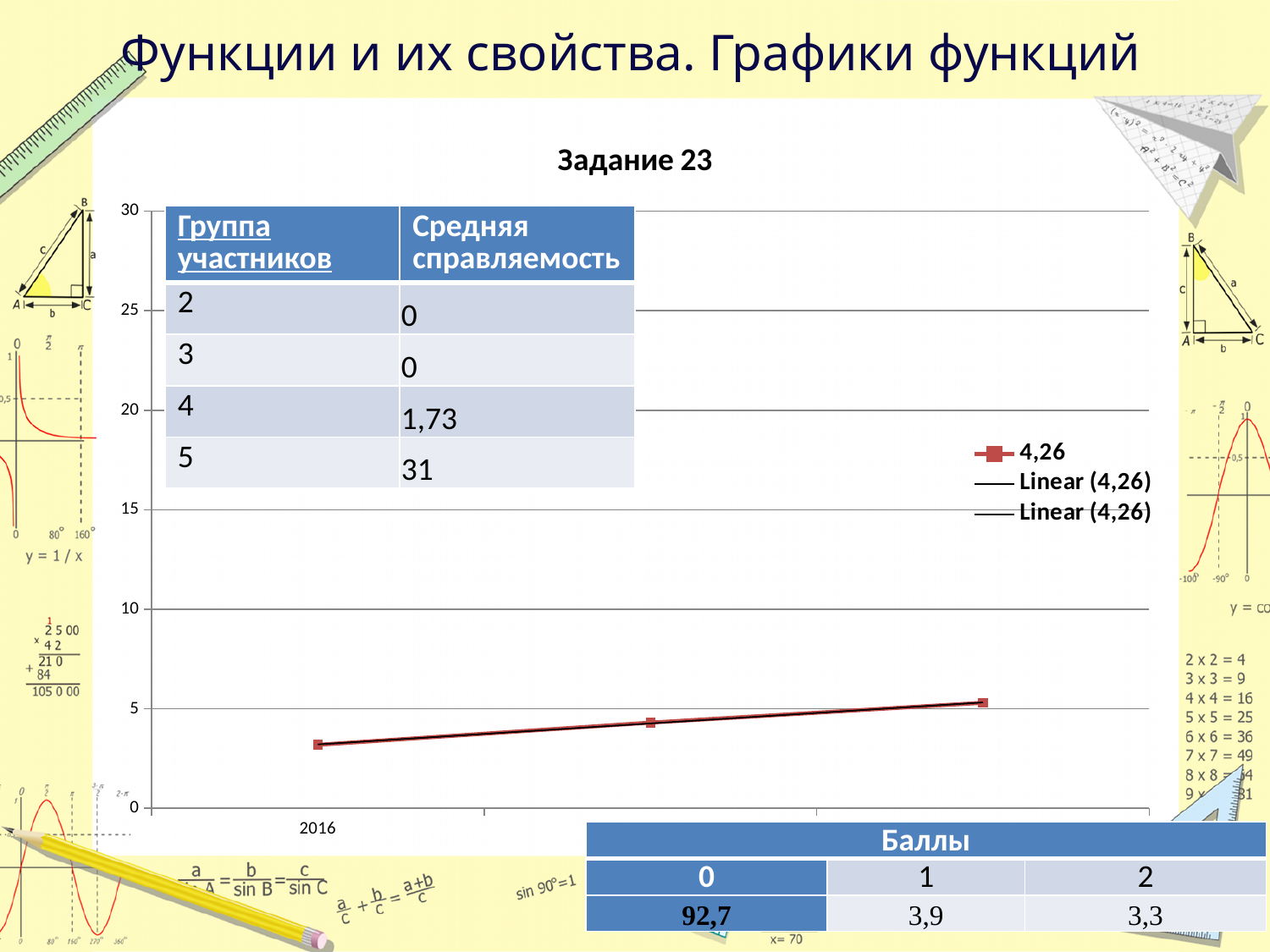
How many data points are plotted on the line? 3 Do the plotted values rise or fall from left to right along the x axis? rise How many entries does the chart legend list? 3 Is the value for 2016 greater or less than 5? less What is the name of the first series listed in the legend? 4,26 Is the value for 2016 greater or less than 10? less What is the title of the chart? Задание 23 What is the highest value shown on the y axis? 30 Is the highest plotted point greater or less than 10? less What kind of chart is shown on the slide? line chart